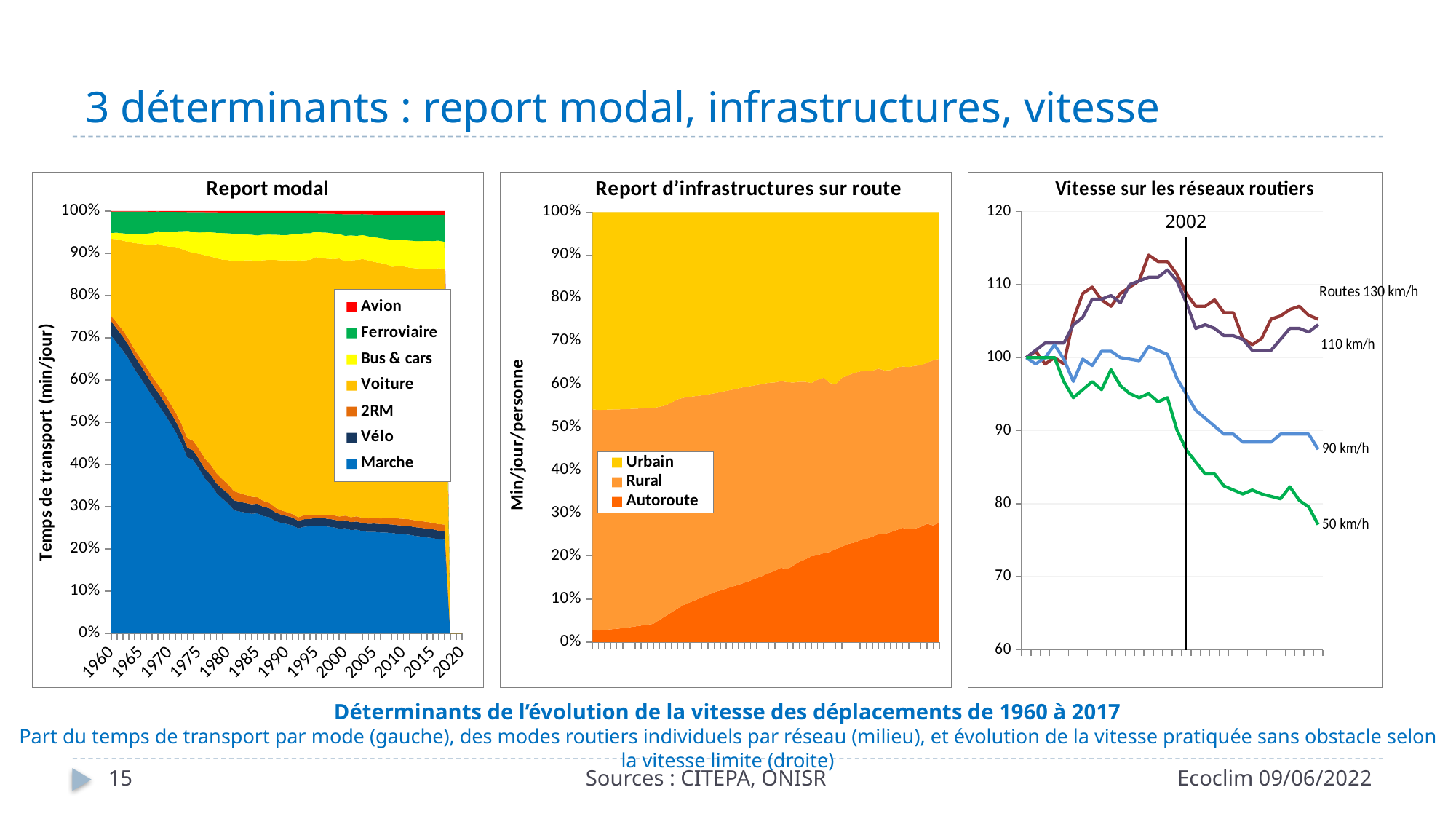
In the 'Report modal' chart, is the share of Marche in 1960 greater or less than 60%? greater In the 'Report modal' chart, is the share of Marche in 2015 greater or less than 30%? less In the 'Vitesse sur les réseaux routiers' chart, which line is lowest at the right end of the chart? 50 km/h In the 'Report d'infrastructures sur route' chart, does the Autoroute share rise or fall along the x axis? rise In the 'Vitesse sur les réseaux routiers' chart, is the value of the 50 km/h line at the right end greater or less than 80? less What kind of chart is 'Vitesse sur les réseaux routiers'? Line chart In the 'Vitesse sur les réseaux routiers' chart, at the right end, which is larger: the Routes 130 km/h line or the 50 km/h line? Routes 130 km/h In the 'Report modal' chart, does the share of Marche rise or fall from 1960 to 2015? fall In the 'Vitesse sur les réseaux routiers' chart, which year is marked by the vertical black line? 2002 In the 'Report modal' chart, how many series does the legend list? 7 In the 'Report d'infrastructures sur route' chart, how many series does the legend list? 3